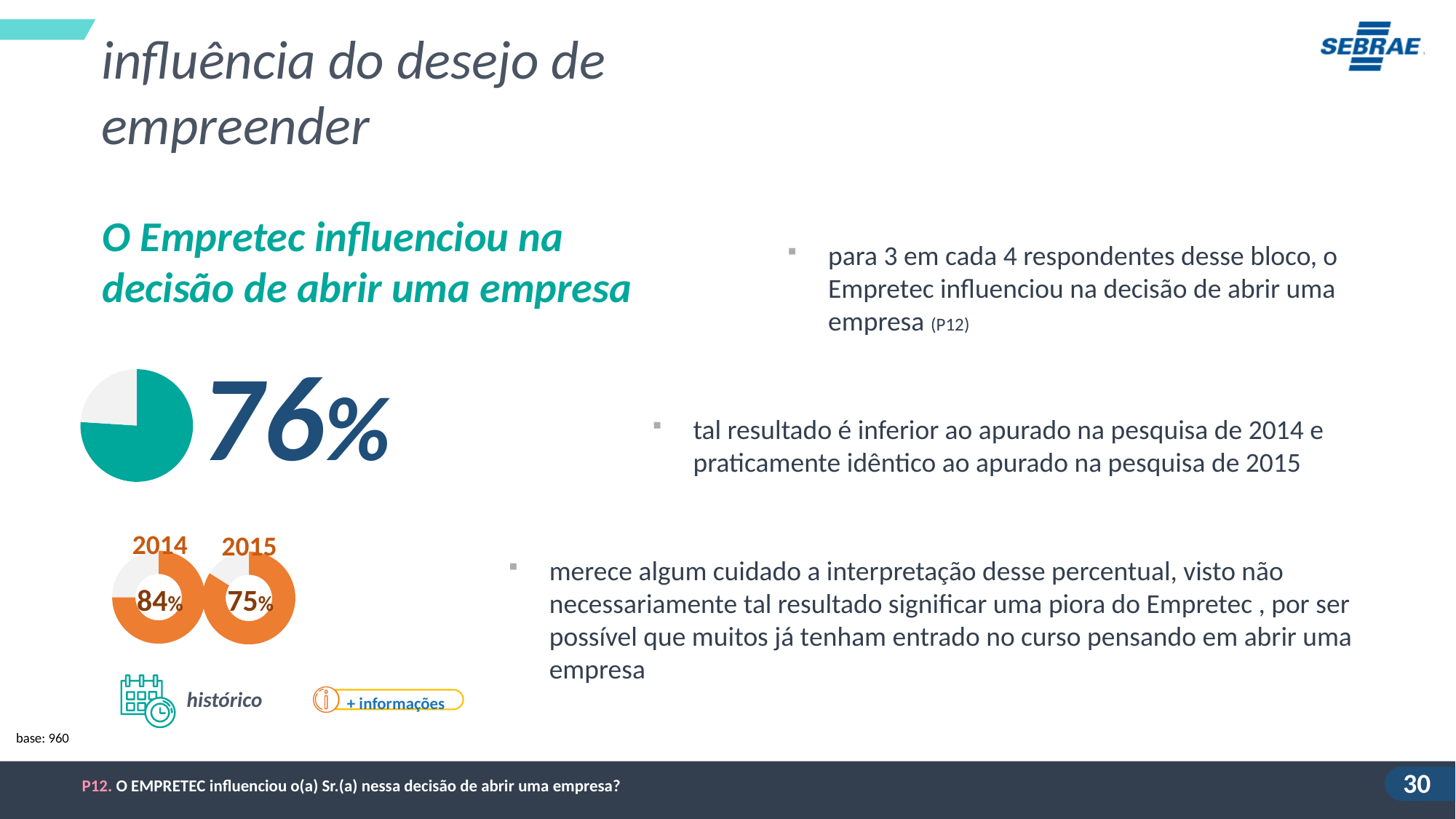
Among the three charts on the slide (current, 2014, 2015), which shows the highest percentage? 2014 (84%) In the small historical donut charts, what value is shown for 2014? 84% What is the difference in percentage points between the 2014 value (84%) and the current value shown in the large pie chart (76%)? 8 percentage points In the small historical donut charts, what value is shown for 2015? 75% What kind of chart is the large chart showing 76%? Pie chart Did the value fall or rise from 2014 to 2015 in the historical donut charts? Fall What colour is the filled portion of the large pie chart showing 76%? Teal Among the three charts on the slide (current, 2014, 2015), which shows the lowest percentage? 2015 (75%) What is the difference in percentage points between the 2014 value and the 2015 value in the historical donut charts? 9 percentage points What percentage is shown by the large pie chart on the left of the slide? 76% How many historical donut charts are shown under the large pie chart? 2 Which year in the historical donut charts has the higher value, 2014 or 2015? 2014